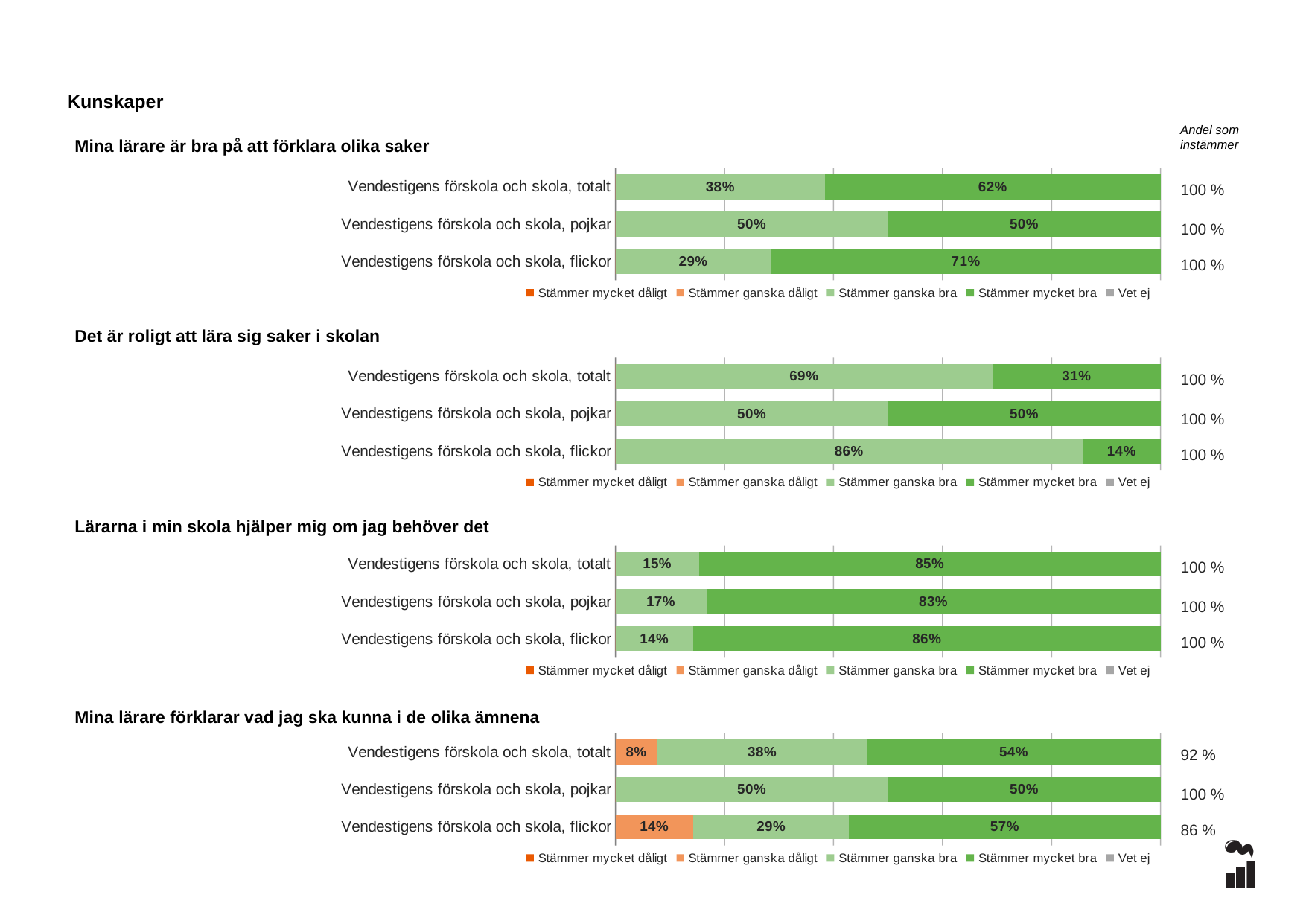
In the chart 'Det är roligt att lära sig saker i skolan', what is the 'Stämmer mycket bra' value for 'Vendestigens förskola och skola, totalt'? 31% In the chart 'Mina lärare förklarar vad jag ska kunna i de olika ämnena', what is the 'Andel som instämmer' value for 'Vendestigens förskola och skola, totalt'? 92 % How many categories are shown in the chart 'Lärarna i min skola hjälper mig om jag behöver det'? 3 In the chart 'Lärarna i min skola hjälper mig om jag behöver det', what is the difference between the 'Stämmer mycket bra' values for flickor and pojkar? 3% What kind of chart is 'Mina lärare är bra på att förklara olika saker'? Stacked bar chart In the chart 'Det är roligt att lära sig saker i skolan', which category has the highest 'Stämmer ganska bra' value? Vendestigens förskola och skola, flickor How many series does the legend list for the chart 'Det är roligt att lära sig saker i skolan'? 5 In the chart 'Mina lärare förklarar vad jag ska kunna i de olika ämnena', what is the 'Stämmer ganska dåligt' value for 'Vendestigens förskola och skola, flickor'? 14% In the chart 'Lärarna i min skola hjälper mig om jag behöver det', which category has the lowest 'Stämmer mycket bra' value? Vendestigens förskola och skola, pojkar In the chart 'Mina lärare är bra på att förklara olika saker', what is the 'Stämmer ganska bra' value for 'Vendestigens förskola och skola, totalt'? 38% In the chart 'Mina lärare förklarar vad jag ska kunna i de olika ämnena', is the 'Stämmer mycket bra' value larger for totalt or for flickor? flickor In the chart 'Mina lärare är bra på att förklara olika saker', what is the 'Stämmer mycket bra' value for 'Vendestigens förskola och skola, flickor'? 71%